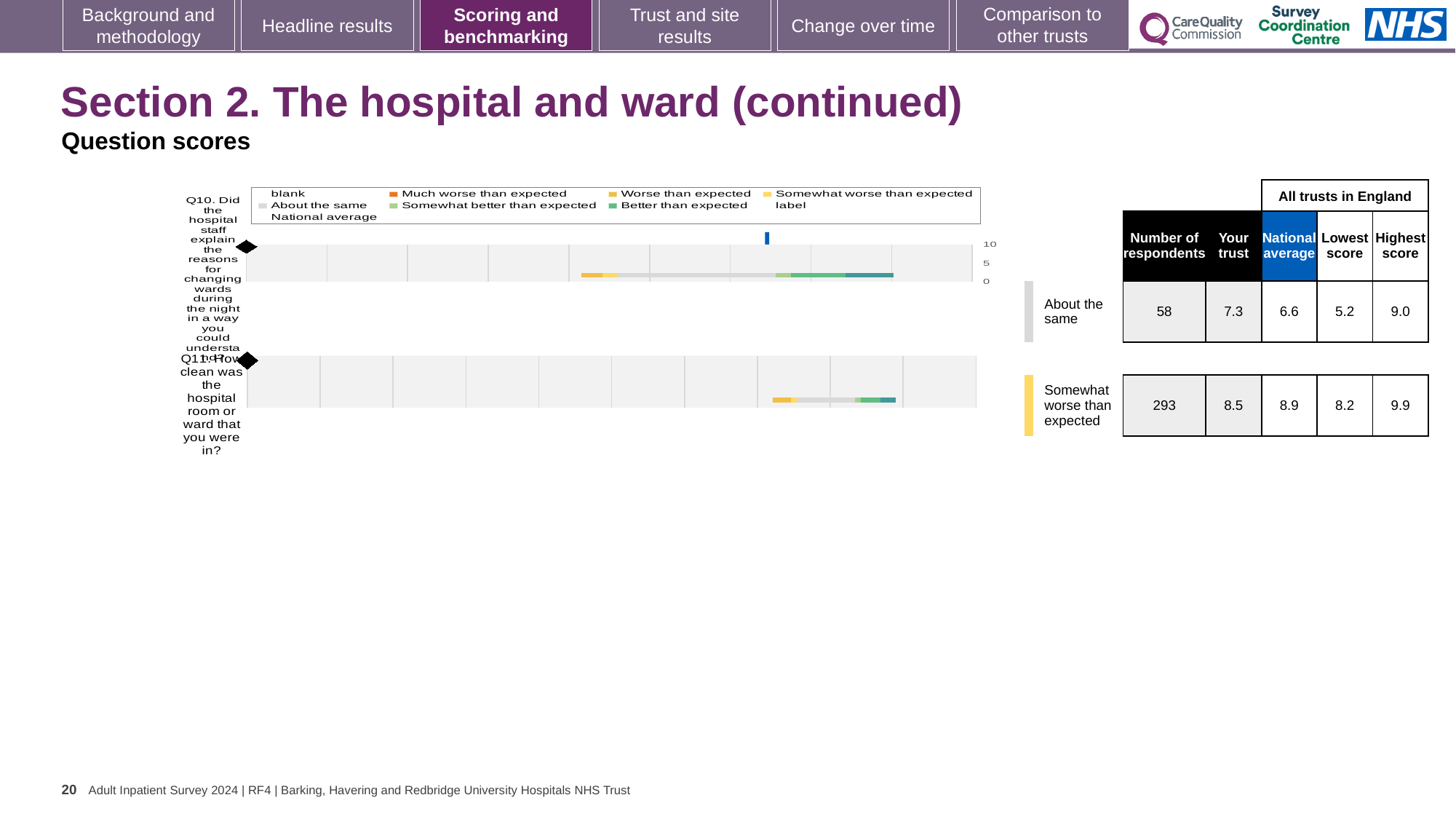
Which question has the higher 'Your trust' score, Q10 or Q11? Q11 How many survey questions are plotted on the chart? 2 What is the maximum value shown on the score axis of the chart? 10 Which benchmark category is the trust's Q11 score placed in? Somewhat worse than expected What is the highest score among all trusts in England for Q10? 9.0 What is the national average score for Q11 (how clean was the hospital room or ward)? 8.9 What is the difference between the national average and the trust's score for Q11? 0.4 What kind of chart is used to show the Q10 and Q11 question scores? bar chart What is the difference between the trust's score and the national average for Q10? 0.7 What is the 'Your trust' score for Q10 (explaining reasons for changing wards during the night)? 7.3 How many respondents answered Q11? 293 What is the lowest score among all trusts in England for Q11? 8.2